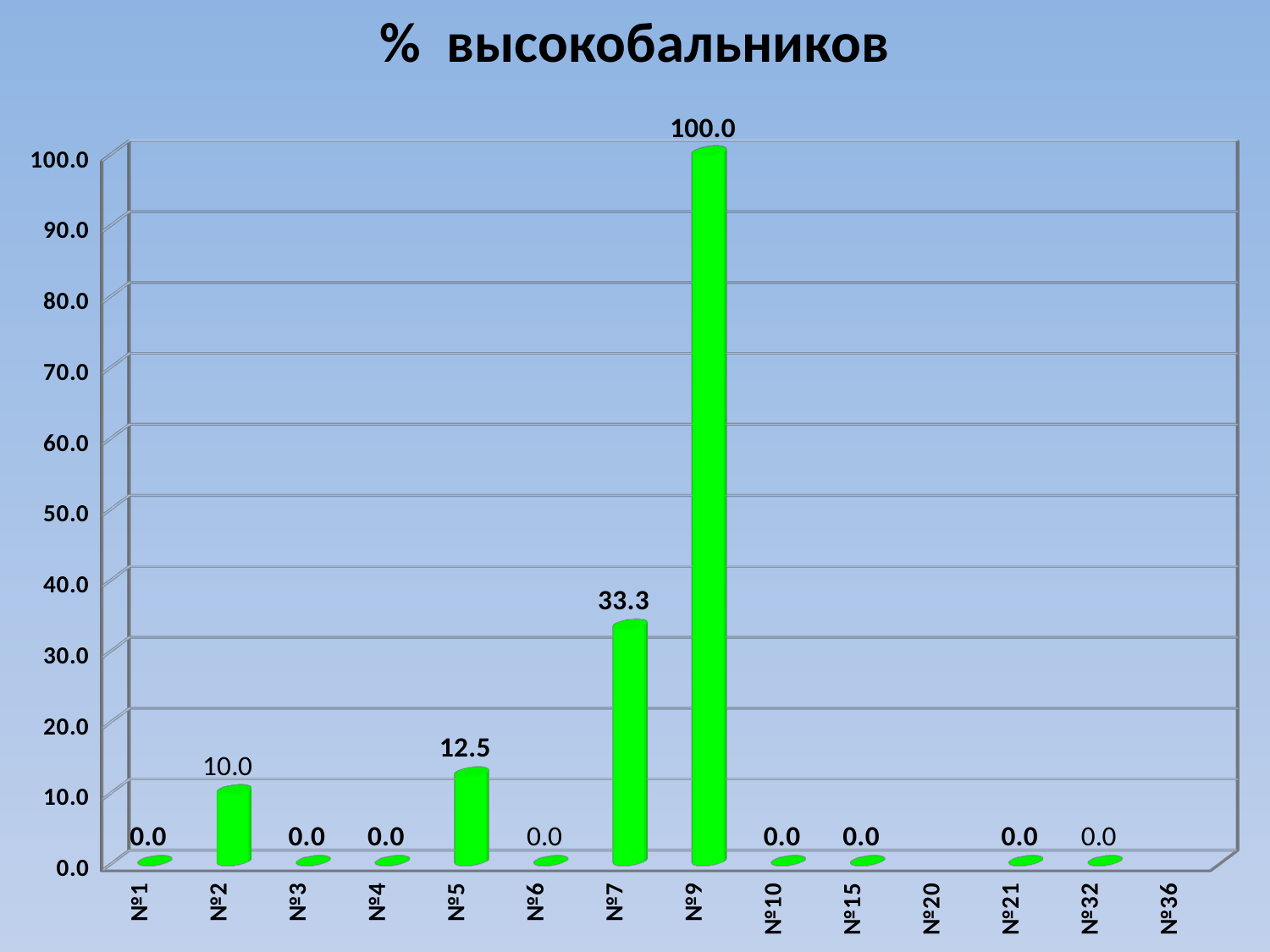
What is the value for №7? 33.3 Which has a larger value, №5 or №2? №5 What is the difference between the values for №5 and №2? 2.5 What is the value for №5? 12.5 Which category has the highest value? №9 What kind of chart is shown on the slide? Bar chart What is the value for №2? 10.0 Is the value for №7 greater or less than 30.0? greater What is the difference between the values for №9 and №7? 66.7 What is the title of the chart? % высокобальников What is the value for №9? 100.0 How many categories are shown on the x axis? 14